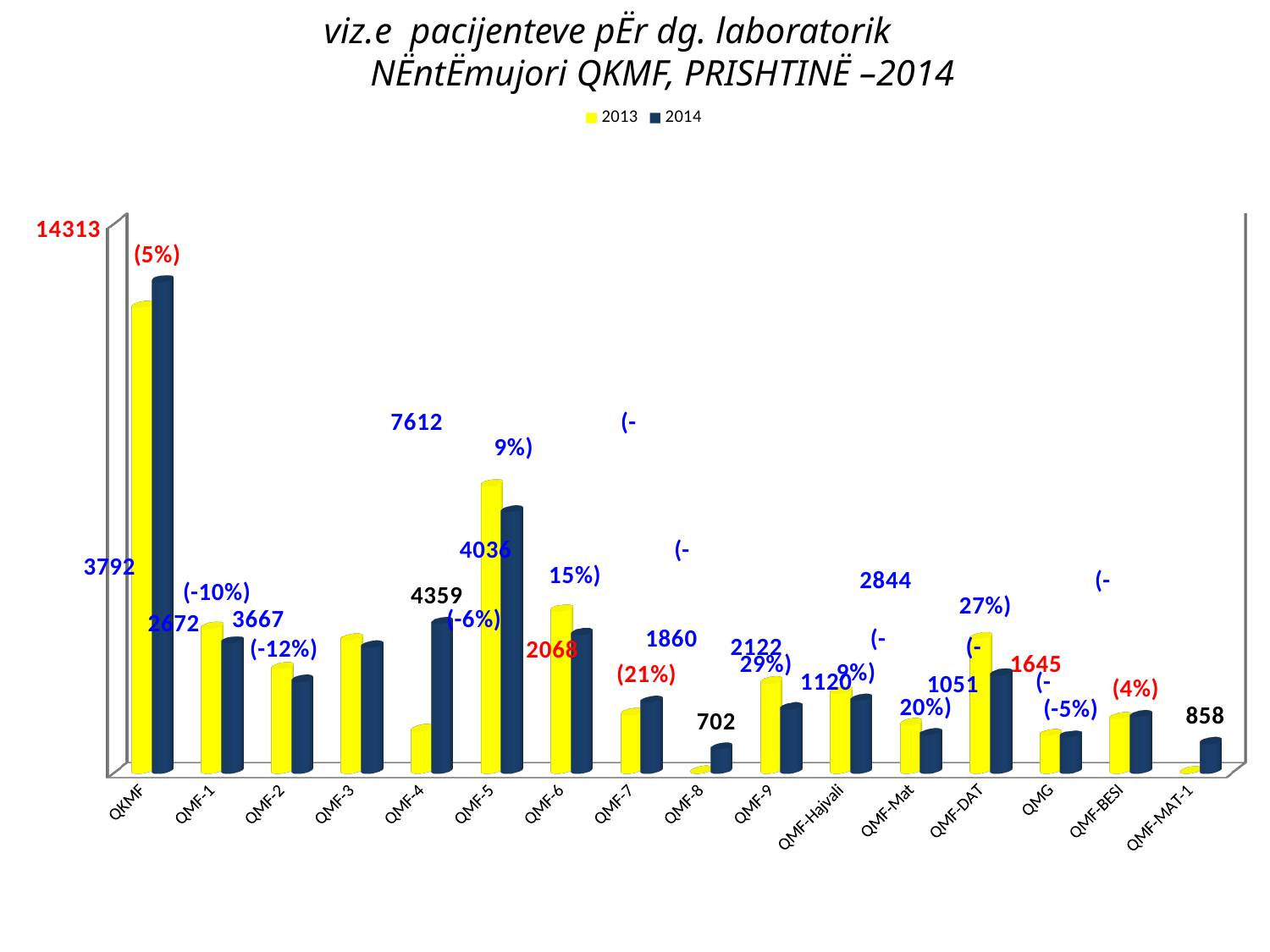
Which category has the highest value in the 2014 series? QKMF Which category has the highest value in the 2013 series? QKMF What is the 2014 value for QMF-8? 702 For QMF-4, which series has the larger value, 2013 or 2014? 2014 How many series does the legend list? 2 Which two series are listed in the legend? 2013 and 2014 What is the 2014 value for QKMF? 14313 For QMF-5, which series has the larger value, 2013 or 2014? 2013 How many categories are shown on the x axis? 16 Which colour represents the 2013 series? yellow What is the 2014 value for QMF-MAT-1? 858 What kind of chart is shown on the slide? bar chart